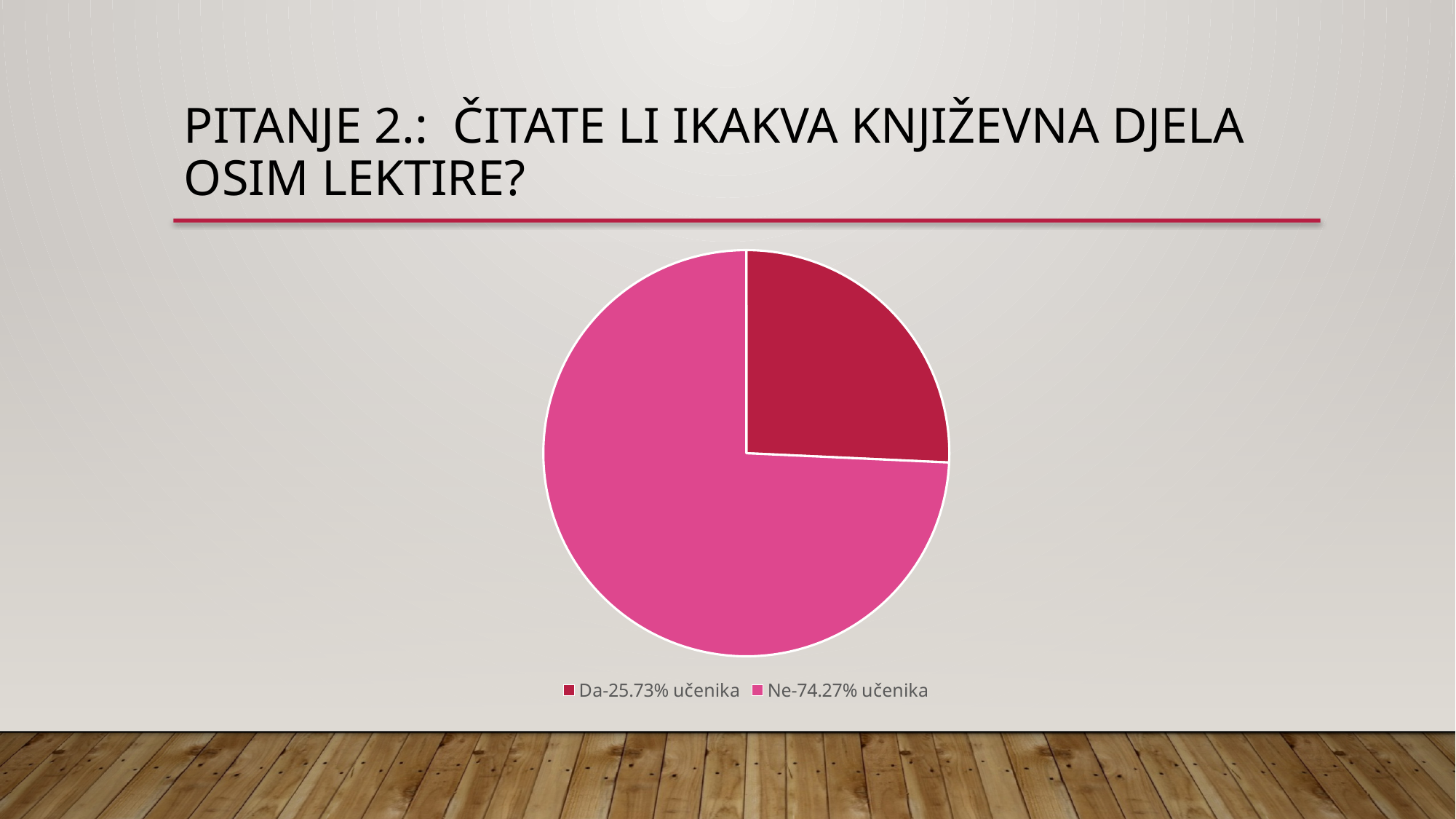
What question is the chart on the slide about, according to the slide title? Čitate li ikakva književna djela osim lektire? Which slice of the pie is the smallest? Da-25.73% učenika What percentage of students is shown for the "Ne" slice? 74.27% Which slice of the pie is the largest? Ne-74.27% učenika How many slices does the pie chart have? 2 What is the difference in percentage points between the "Ne" slice and the "Da" slice? 48.54 What share of the pie does the "Ne" slice represent? 74.27% What kind of chart is shown on the slide? pie chart How many entries does the legend list? 2 What percentage of students is shown for the "Da" slice? 25.73% What colour is the "Da" slice in the pie chart? dark red Which is larger, the "Da" slice or the "Ne" slice? Ne